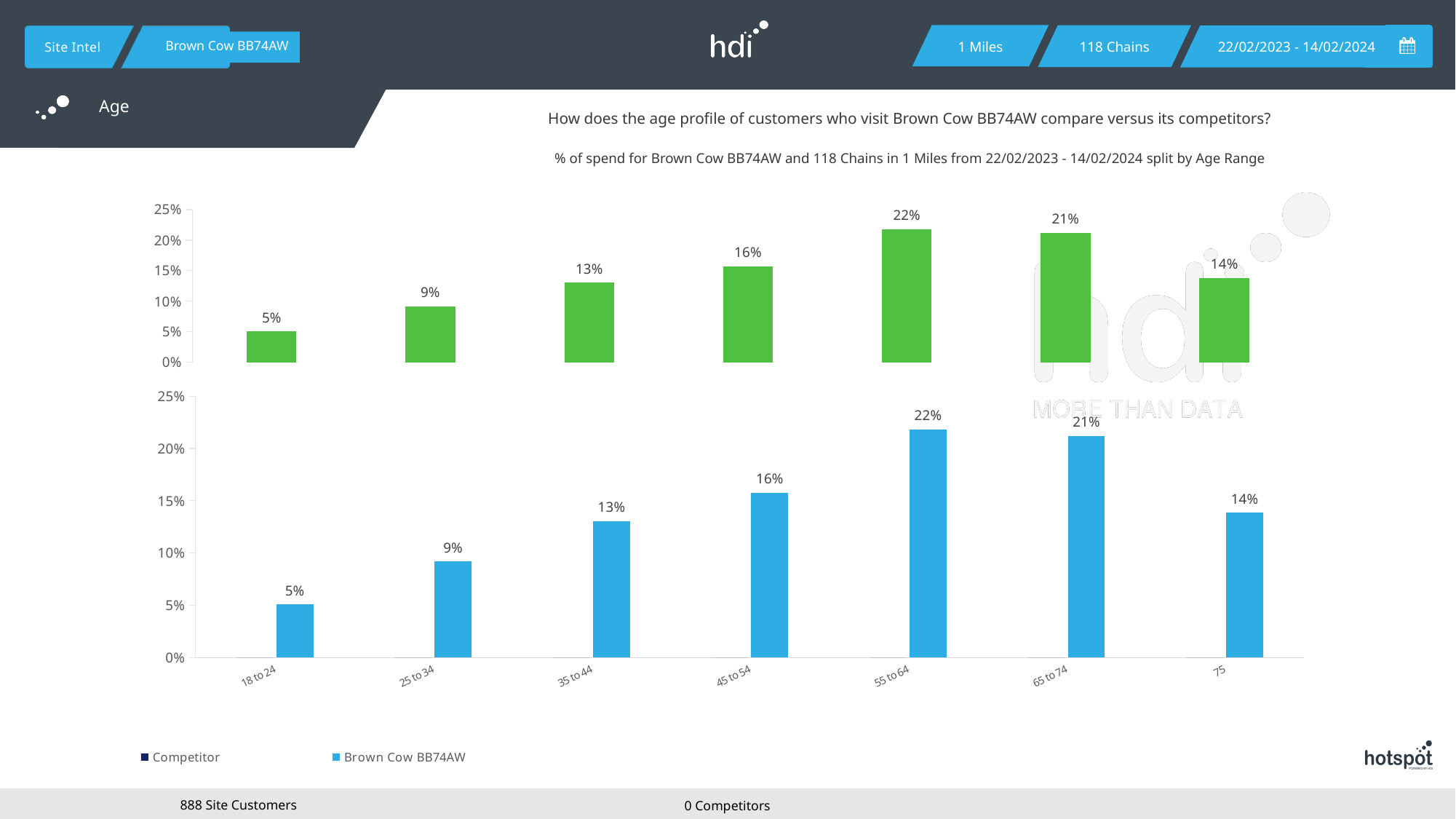
In the bottom chart, what is the difference between the values for 45 to 54 and 35 to 44? 3% In the bottom chart, what is the value for the 55 to 64 age range? 22% In the bottom chart, what is the value for the 75 age range? 14% In the top chart, which age range has the highest value? 55 to 64 What kind of chart is the bottom chart? bar chart In the top chart, which is larger, the value for 65 to 74 or the value for 75? 65 to 74 How many series does the legend list? 2 What are the two entries in the legend? Competitor and Brown Cow BB74AW In the bottom chart, is the value for 45 to 54 greater or less than 15%? greater How many age range categories are shown on the x axis of the bottom chart? 7 In the bottom chart, which age range has the lowest value? 18 to 24 In the top chart, what is the value for the 25 to 34 age range? 9%